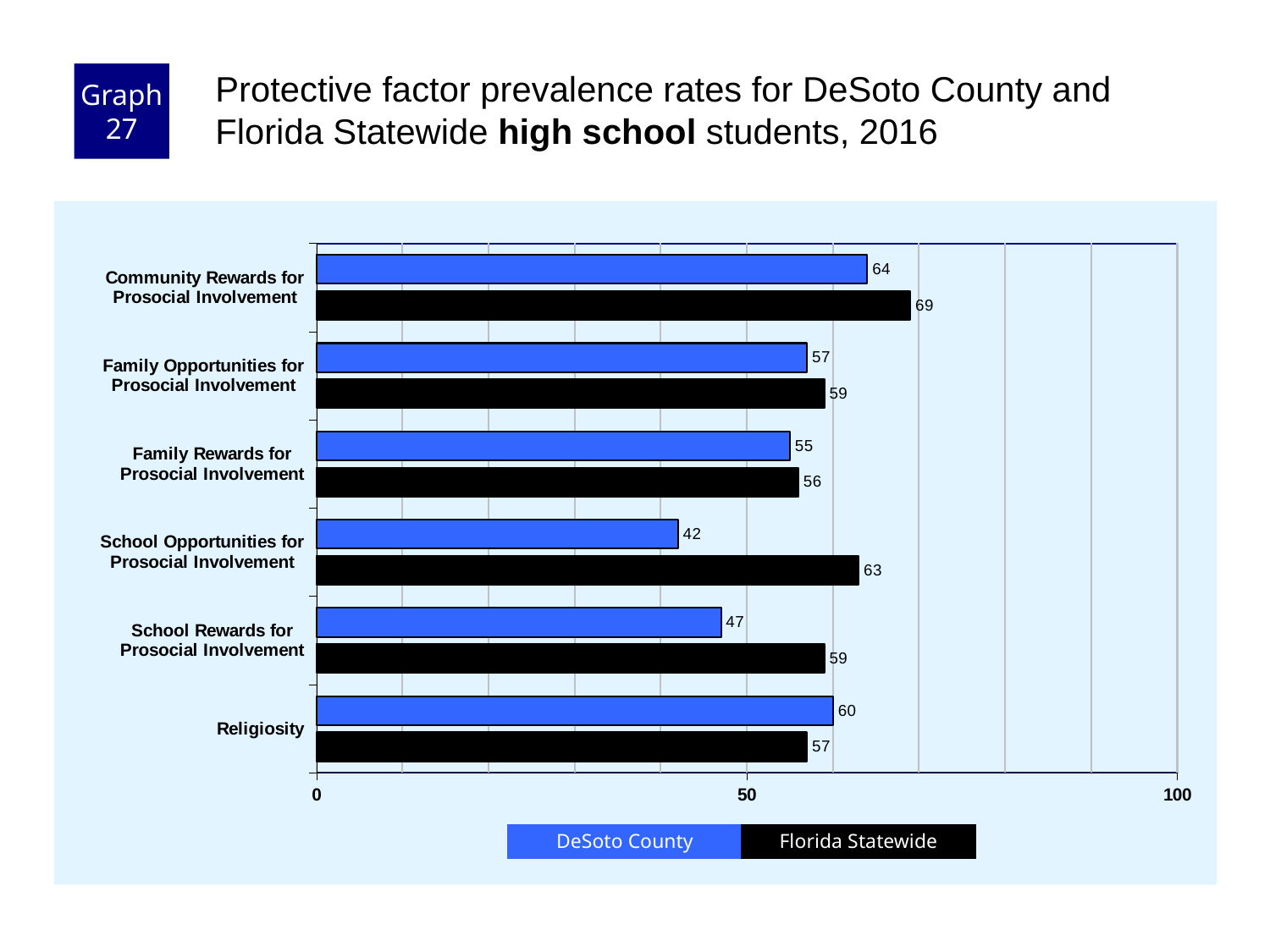
Which category has the lowest DeSoto County value? School Opportunities for Prosocial Involvement Which category has the highest Florida Statewide value? Community Rewards for Prosocial Involvement What is the Florida Statewide value for School Opportunities for Prosocial Involvement? 63 How many series does the legend list? 2 Is the DeSoto County value for School Opportunities for Prosocial Involvement greater or less than 50? less What is the difference between the Florida Statewide and DeSoto County values for School Opportunities for Prosocial Involvement? 21 What is the difference between the Florida Statewide and DeSoto County values for School Rewards for Prosocial Involvement? 12 For Religiosity, which is larger: the DeSoto County value or the Florida Statewide value? DeSoto County What kind of chart is shown on the slide? bar chart How many categories are shown on the chart? 6 What is the DeSoto County value for Community Rewards for Prosocial Involvement? 64 What is the DeSoto County value for Religiosity? 60